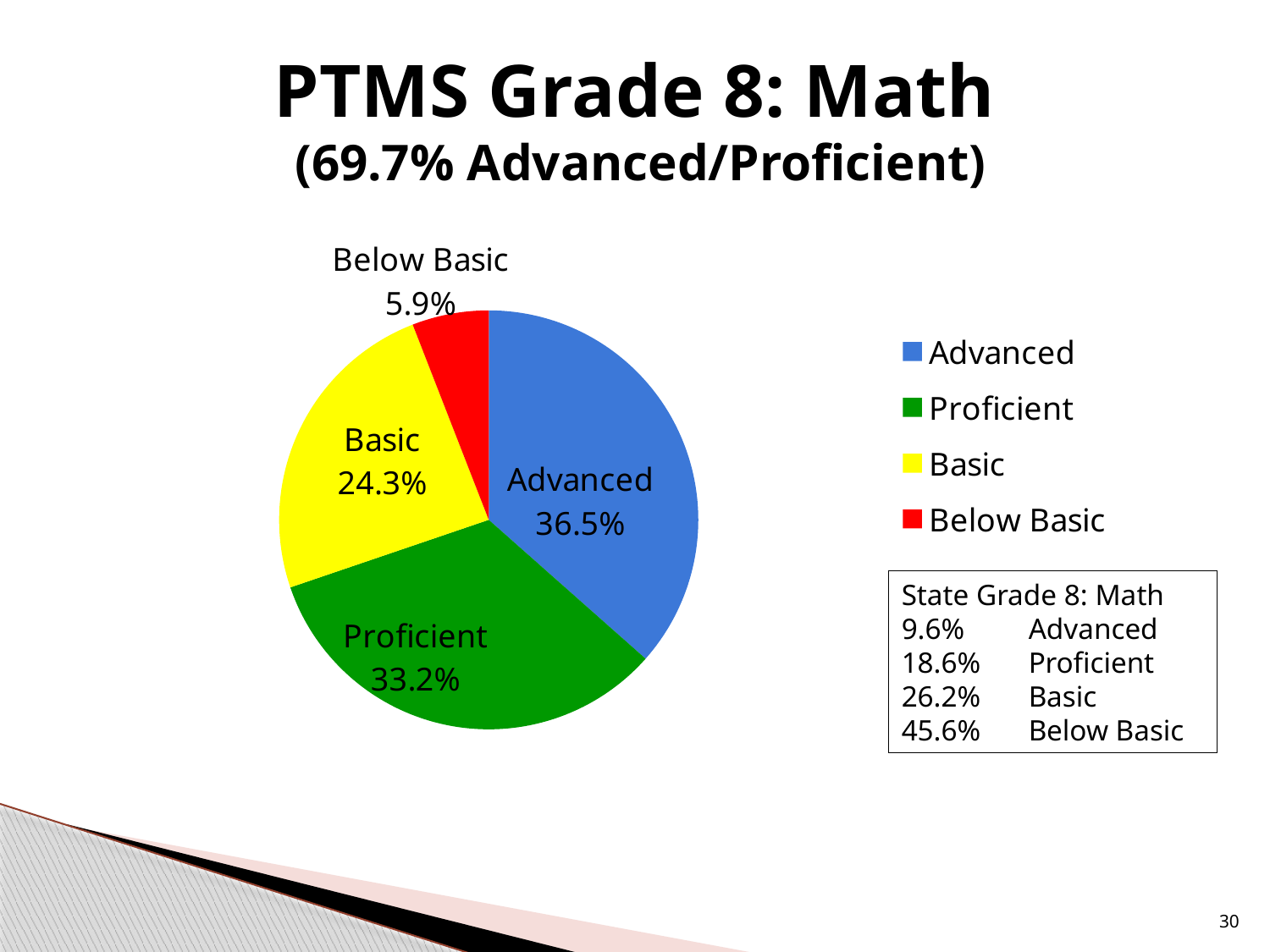
What percentage of PTMS Grade 8 students scored Proficient in Math? 33.2% What colour is the Proficient slice in the pie chart? Green Which performance level has the largest slice of the pie chart? Advanced What is the difference in percentage points between the Advanced and Proficient slices? 3.3 What is the difference in percentage points between the Basic and Below Basic slices? 18.4 What percentage of PTMS Grade 8 students scored Advanced in Math? 36.5% Which slice is larger, Basic or Below Basic? Basic How many slices does the pie chart have? 4 What percentage of PTMS Grade 8 students scored Below Basic in Math? 5.9% What percentage of PTMS Grade 8 students scored Basic in Math? 24.3% Which performance level has the smallest slice of the pie chart? Below Basic What type of chart is shown on the slide? Pie chart